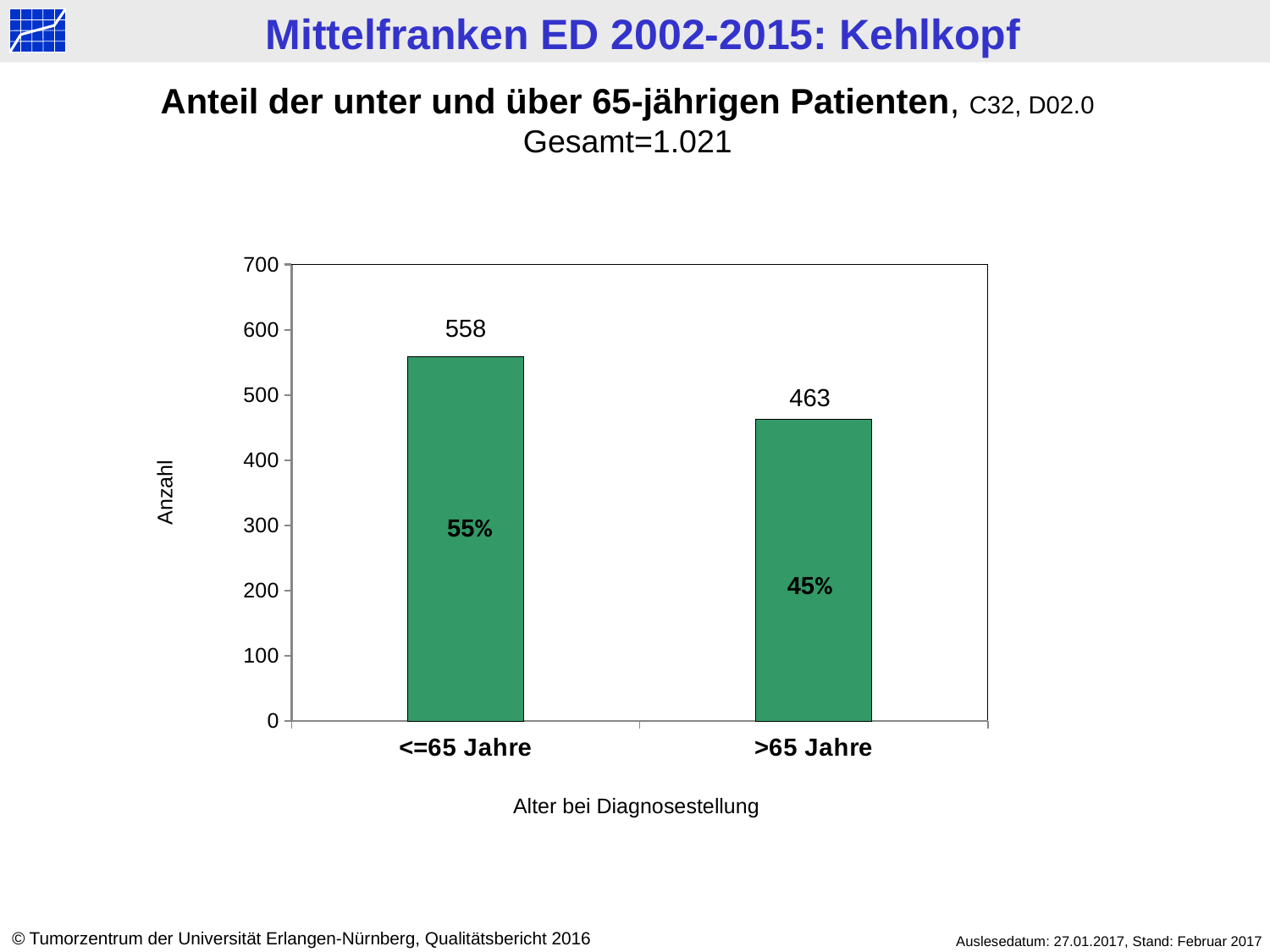
Is the value for >65 Jahre greater or less than 500? less What percentage is printed on the bar for <=65 Jahre? 55% What is the difference between the values for <=65 Jahre and >65 Jahre? 95 What kind of chart is shown on the slide? bar chart What is the value for the >65 Jahre category? 463 What is the value for the <=65 Jahre category? 558 How many categories are shown on the x axis? 2 What is the label of the y axis? Anzahl What percentage is printed on the bar for >65 Jahre? 45% Which age category has the highest value? <=65 Jahre Which age category has the lowest value? >65 Jahre Which is larger, the value for <=65 Jahre or for >65 Jahre? <=65 Jahre